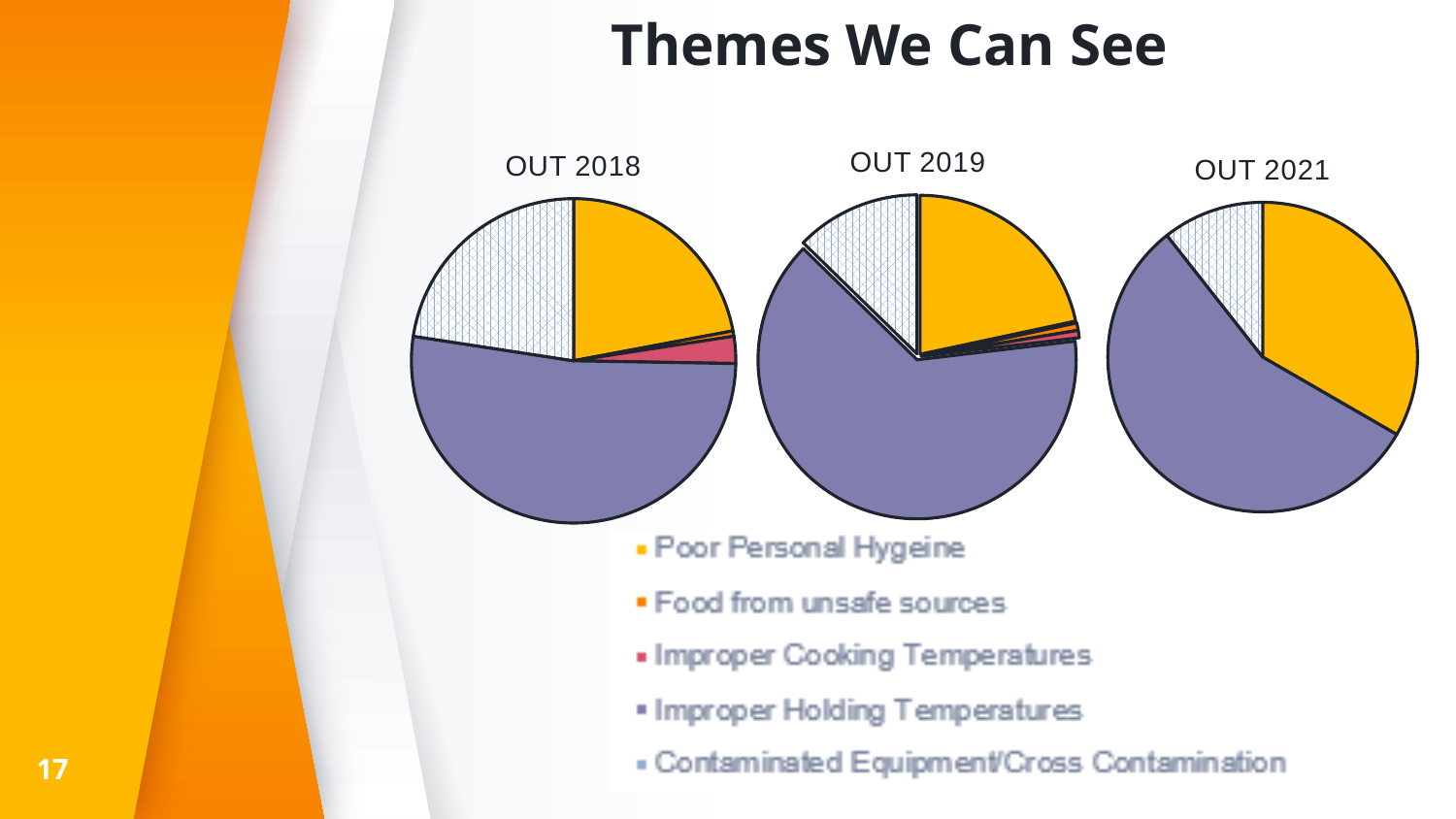
In the OUT 2019 pie chart, which slice is larger: Poor Personal Hygeine or Contaminated Equipment/Cross Contamination? Poor Personal Hygeine In the OUT 2018 pie chart, which category has the largest slice? Improper Holding Temperatures How many entries does the legend list? 5 How many pie charts are shown on the slide? 3 In the OUT 2018 pie chart, which slice is larger: Improper Holding Temperatures or Poor Personal Hygeine? Improper Holding Temperatures Which legend entry is shown with a hatched blue pattern? Contaminated Equipment/Cross Contamination In the OUT 2021 pie chart, which slice is larger: Poor Personal Hygeine or Contaminated Equipment/Cross Contamination? Poor Personal Hygeine What is the title of the pie chart on the far right? OUT 2021 How many slices are visible in the OUT 2021 pie chart? 3 In the OUT 2021 pie chart, which category has the largest slice? Improper Holding Temperatures In the OUT 2019 pie chart, which category has the largest slice? Improper Holding Temperatures What kind of chart is used for OUT 2018? pie chart